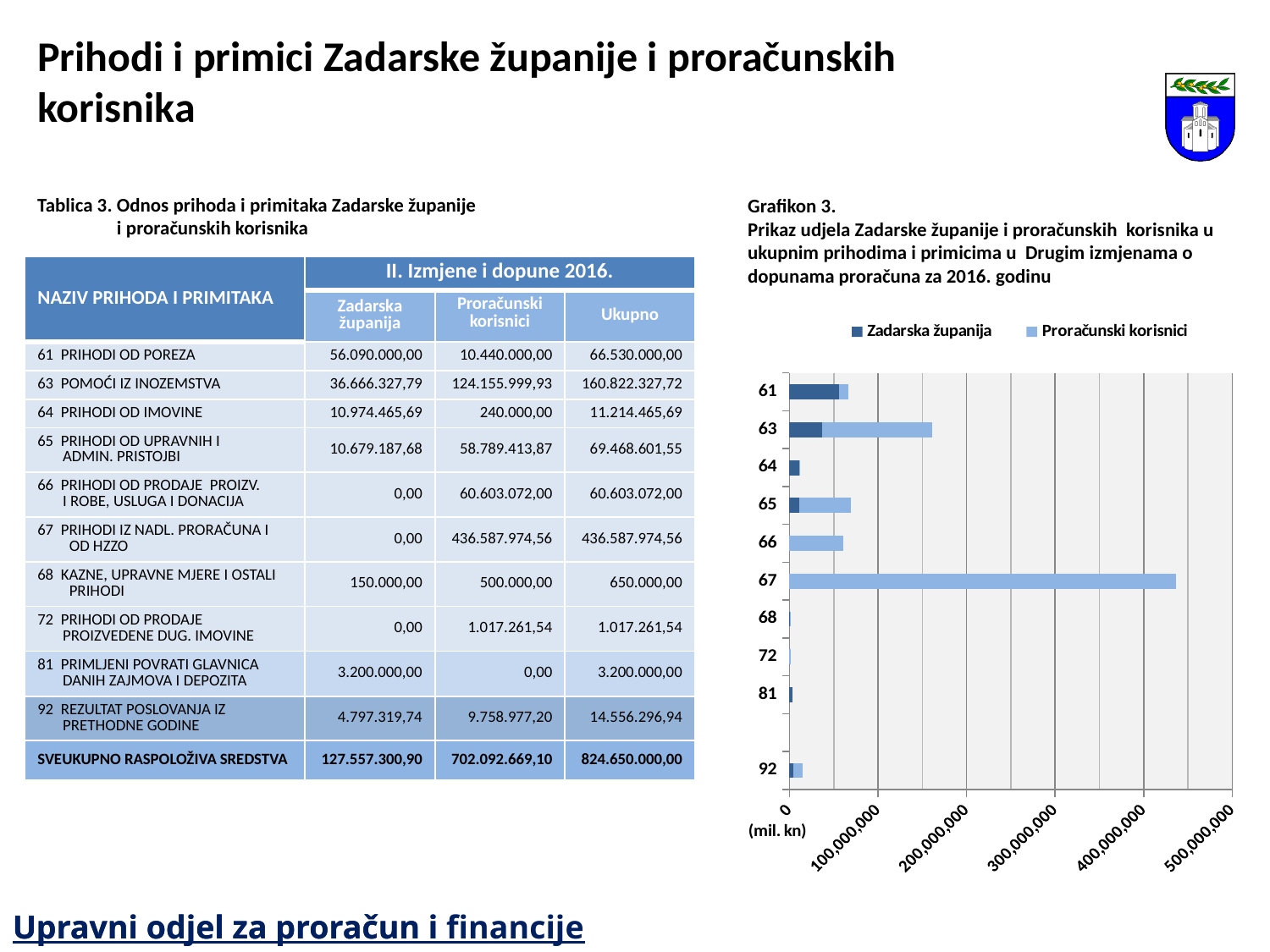
In Grafikon 3, is the total bar for category 63 greater or less than 100,000,000? greater How many categories are plotted on the vertical axis of Grafikon 3? 10 In Grafikon 3, which has the longer bar, category 67 or category 63? 67 What are the two legend entries in Grafikon 3? Zadarska županija, Proračunski korisnici In Grafikon 3, is the total bar for category 67 greater or less than 400,000,000? greater In Grafikon 3, is the total bar for category 61 greater or less than 100,000,000? less How many series does the legend of Grafikon 3 list? 2 In Grafikon 3, which has the longer bar, category 63 or category 61? 63 Which category has the longest bar in Grafikon 3? 67 What kind of chart is Grafikon 3? bar chart What unit label is shown next to the 0 on the horizontal axis of Grafikon 3? (mil. kn)